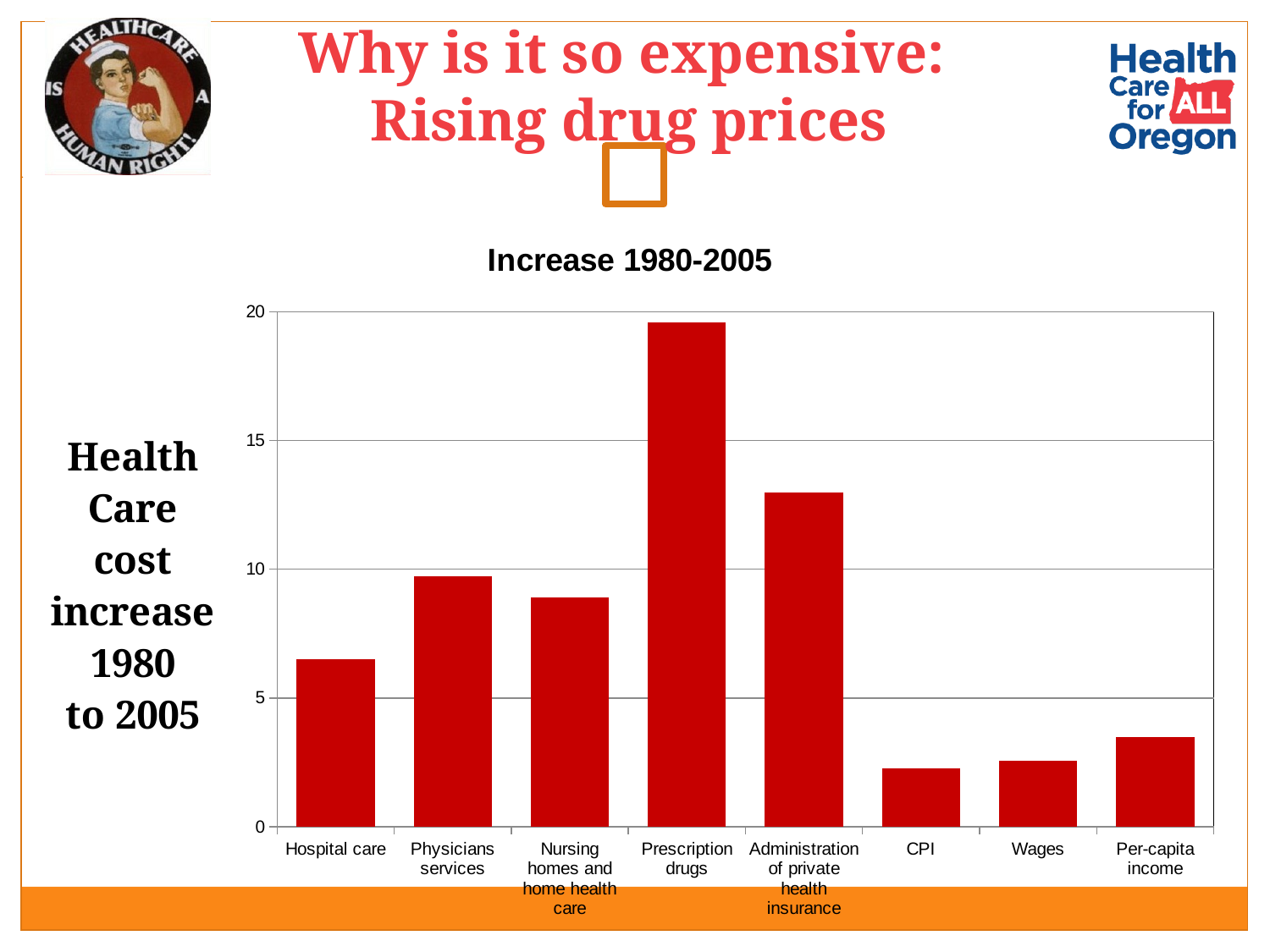
Which is larger, the value for Per-capita income or the value for CPI? Per-capita income How many categories are shown on the x axis of the chart? 8 Is the value for Wages greater or less than 5? less What colour are the bars in the chart? red Which is larger, the value for Physicians services or the value for Hospital care? Physicians services Which category has the highest value in the chart? Prescription drugs What kind of chart is shown on the slide? bar chart Is the value for Hospital care greater or less than 10? less Is the value for Administration of private health insurance greater or less than 10? greater What is the title of the chart? Increase 1980-2005 Which is larger, the value for Prescription drugs or the value for Administration of private health insurance? Prescription drugs